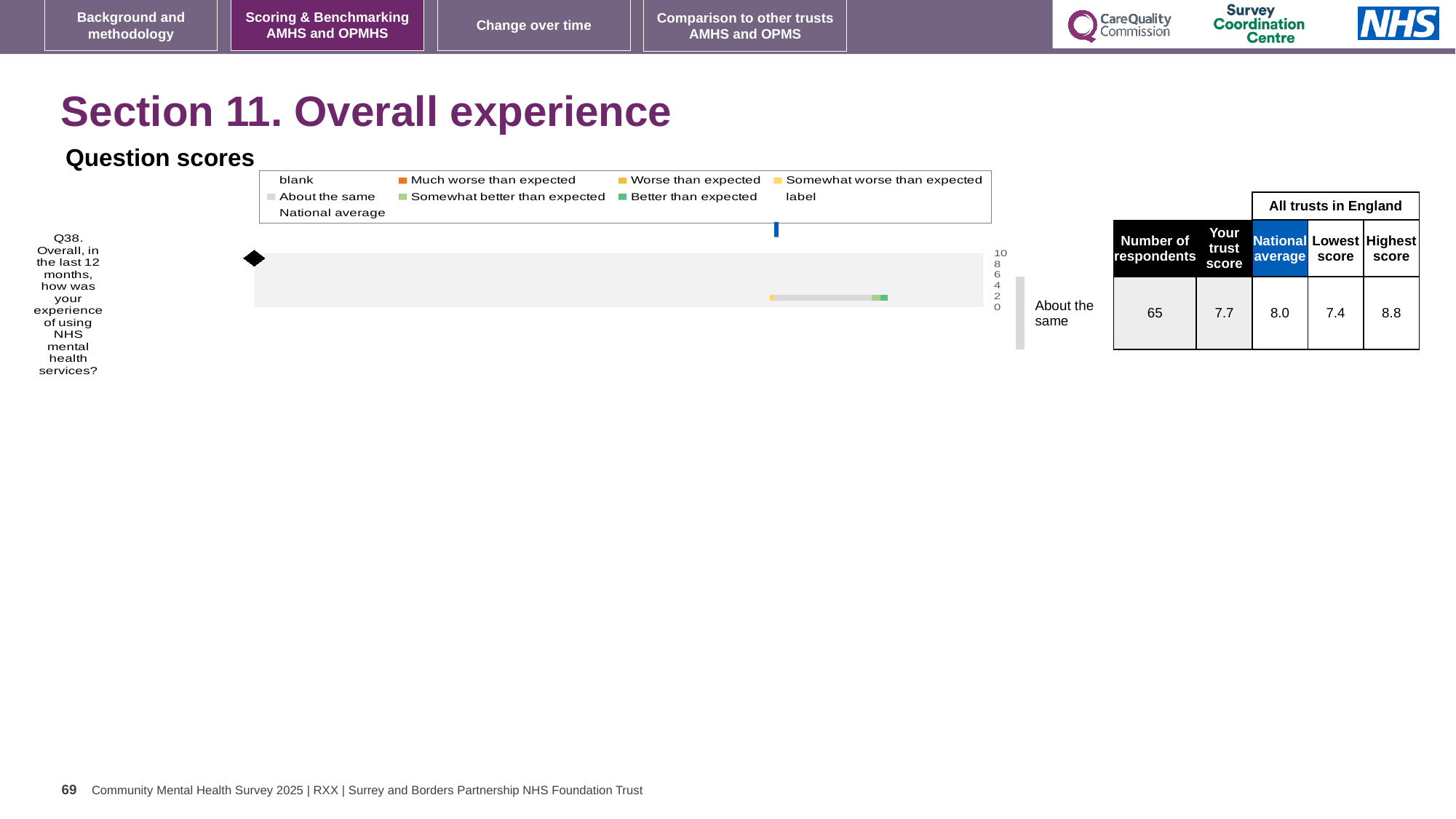
How many survey questions are plotted in the Question scores chart? 1 What is the highest score among all trusts in England for Q38? 8.8 What is the lowest score among all trusts in England for Q38? 7.4 What is the number of respondents for Q38 in the table beside the chart? 65 Which question number is plotted in the Question scores chart? Q38 What benchmark category is shown for Q38 next to the chart? About the same What is 'Your trust score' for Q38 in the table beside the chart? 7.7 For Q38, which is larger: your trust score or the national average? National average What is the national average for Q38 in the table beside the chart? 8.0 In the chart legend, which colour represents 'Much worse than expected'? orange What kind of chart is shown under 'Question scores'? bar chart For Q38, what is the difference between the highest score and the lowest score among all trusts in England? 1.4